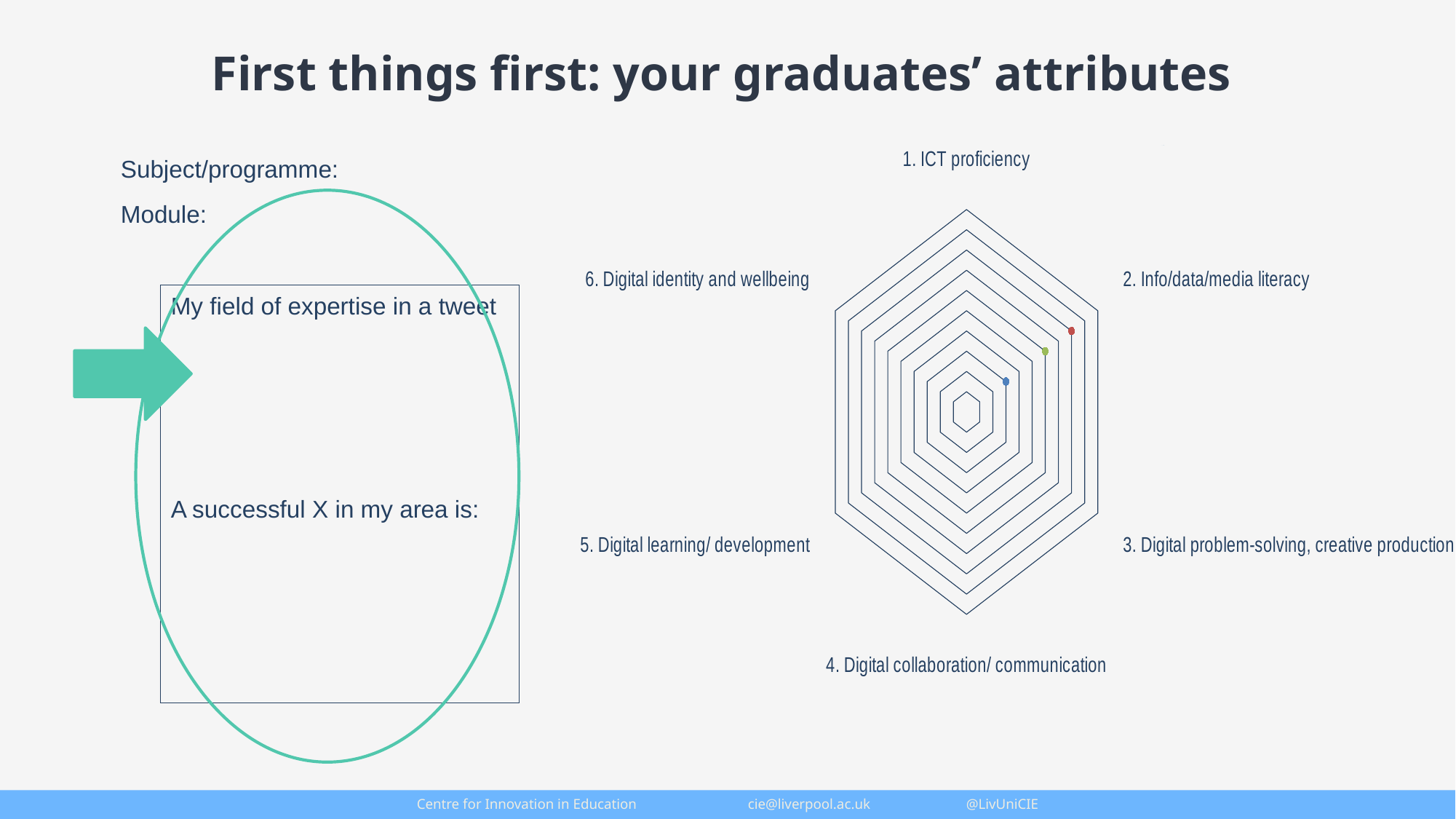
On the radar chart, which plotted point is farther from the centre, the red point or the blue point? the red point Which category label sits at the top of the radar chart? 1. ICT proficiency How many coloured data points are plotted on the radar chart? 3 On the radar chart, which plotted point is closer to the centre, the green point or the blue point? the blue point What kind of chart is shown on the right of the slide? radar chart How many categories (axes) does the radar chart have? 6 Which category label sits at the bottom of the radar chart? 4. Digital collaboration/ communication